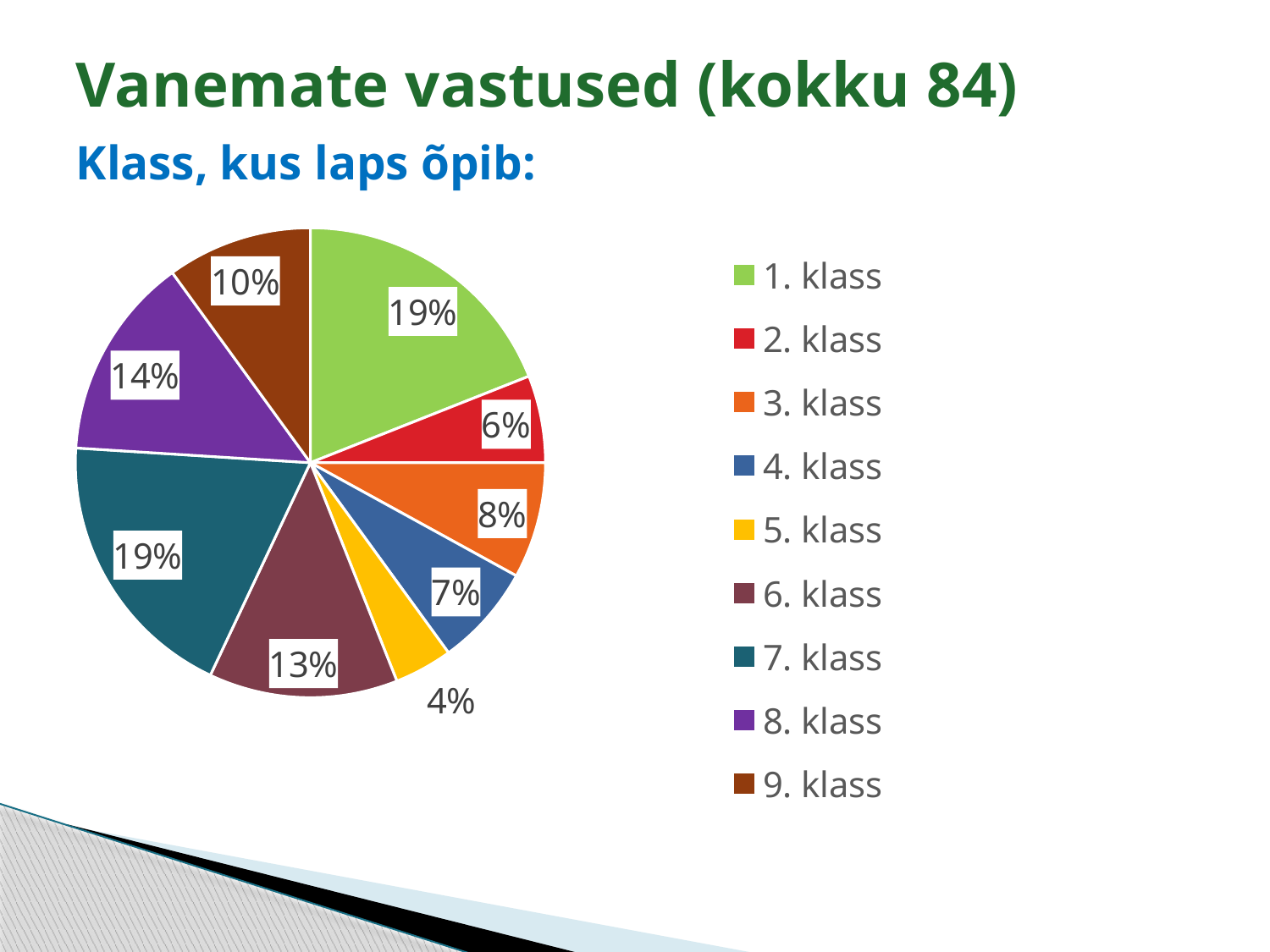
Which class has the smallest slice of the pie? 5. klass What share of the pie does 1. klass have? 19% What share of the pie does 6. klass have? 13% What is the difference between the share for 7. klass and the share for 2. klass? 13% Which is larger, the share for 3. klass or the share for 4. klass? 3. klass What is the difference between the share for 8. klass and the share for 9. klass? 4% How many categories does the legend list? 9 What share of the pie does 5. klass have? 4% What kind of chart is shown on the slide? pie chart What is the subtitle above the pie chart? Klass, kus laps õpib: